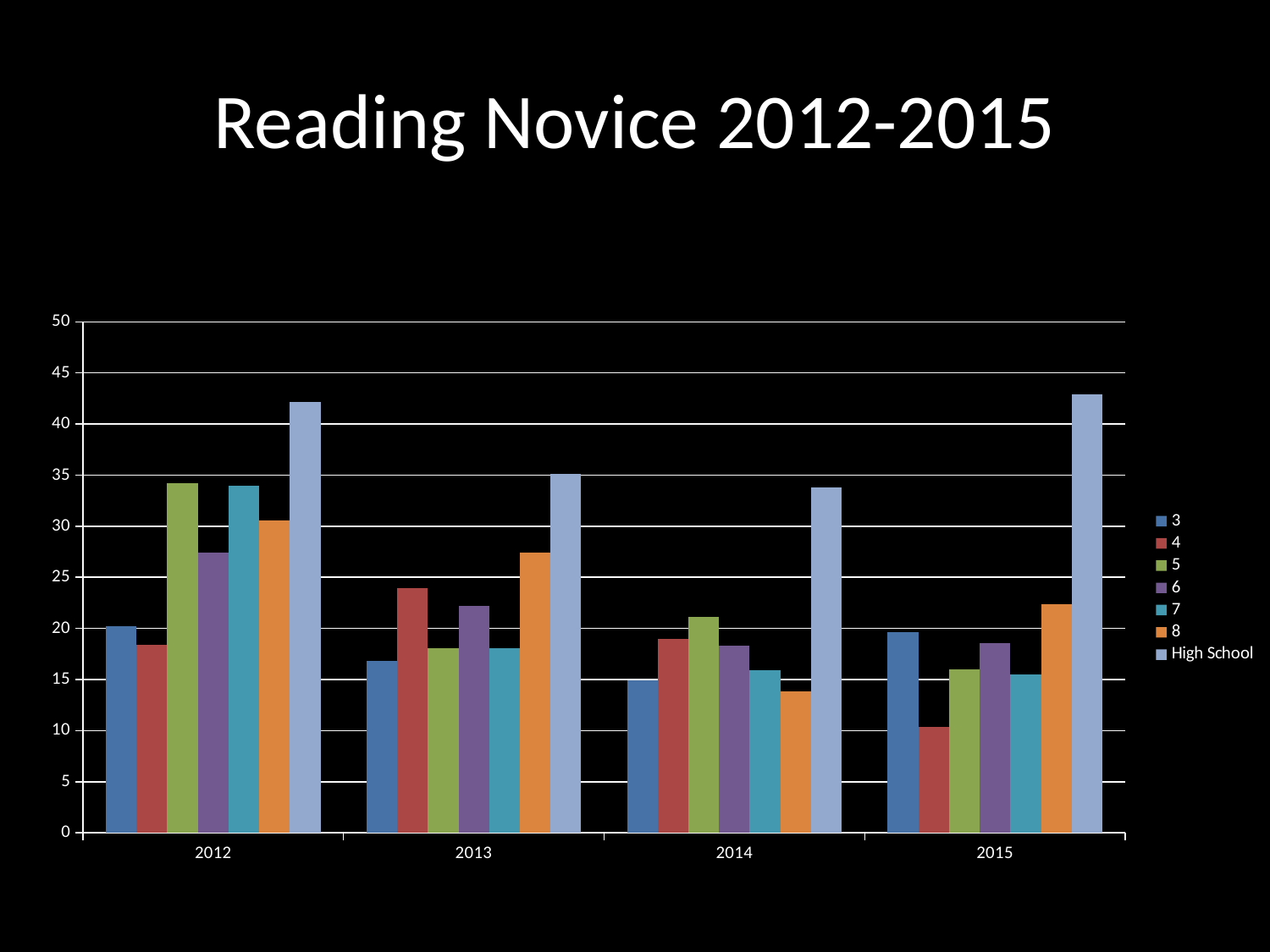
How many series does the legend list? 7 In 2012, which series has the highest value? High School Is the value for High School in 2012 greater or less than 40? greater In 2013, which is larger, the value for series 3 or series 4? 4 What is the title of the chart? Reading Novice 2012-2015 In 2015, which series has the lowest value? 4 Is the value for series 5 in 2012 greater or less than 30? greater Is the value for series 8 in 2014 greater or less than 15? less In 2014, which series has the lowest value? 8 What kind of chart is shown on the slide? bar chart From 2012 to 2014, does the value for series 3 rise or fall? fall How many years are shown on the x axis? 4